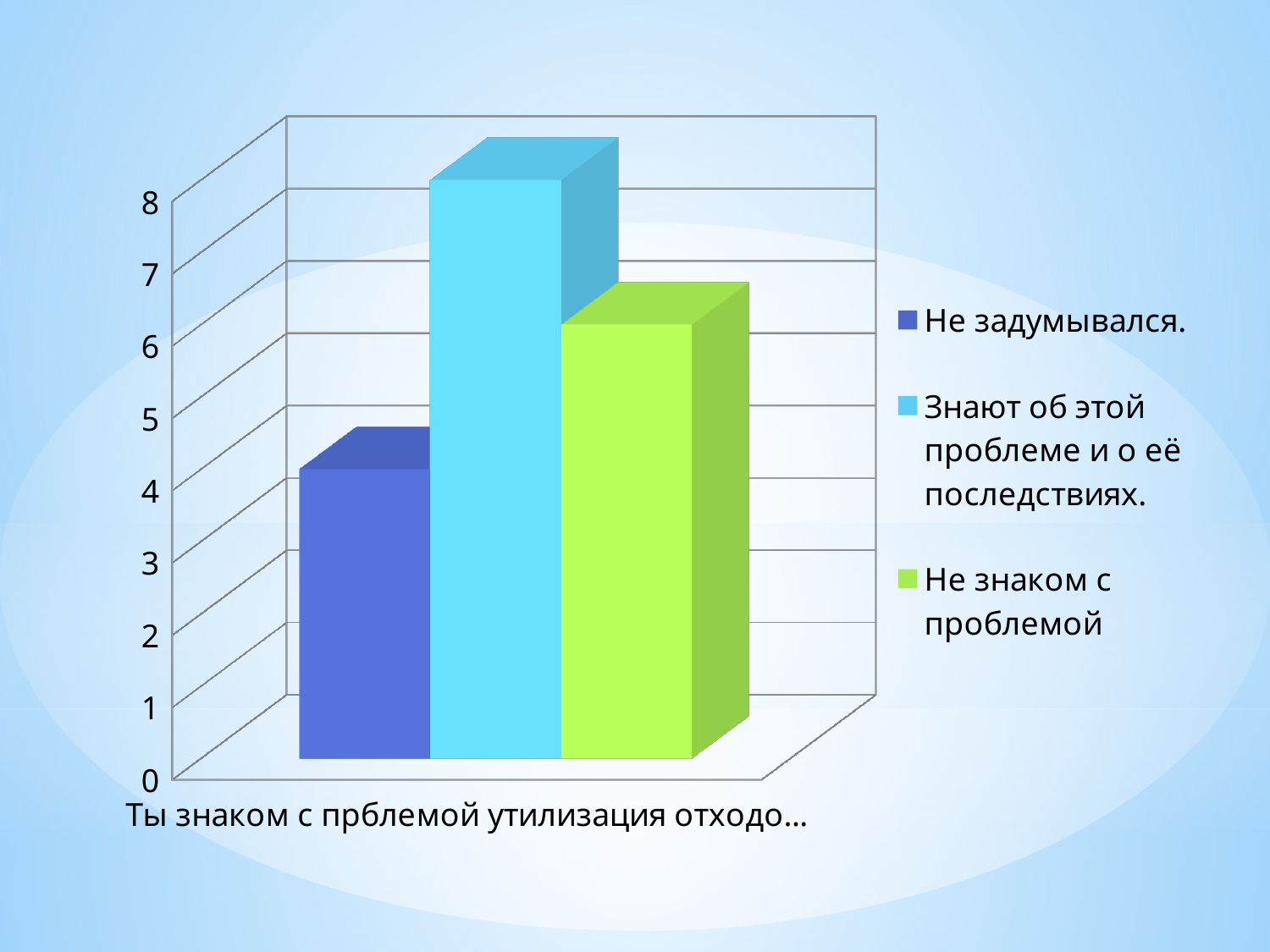
Is the value for "Не задумывался." greater or less than 5? less Which is larger, the bar for "Знают об этой проблеме и о её последствиях." or the bar for "Не знаком с проблемой"? Знают об этой проблеме и о её последствиях. How many series does the legend list? 3 How many categories are shown on the x axis? 1 Is the value for "Знают об этой проблеме и о её последствиях." greater or less than 7? greater Is the value for "Не знаком с проблемой" greater or less than 5? greater What kind of chart is shown on the slide? bar chart Which is larger, the bar for "Не знаком с проблемой" or the bar for "Не задумывался."? Не знаком с проблемой What is the highest value shown on the vertical axis? 8 Which series has the highest bar? Знают об этой проблеме и о её последствиях. What colour is the bar for "Не знаком с проблемой"? green Which series has the lowest bar? Не задумывался.